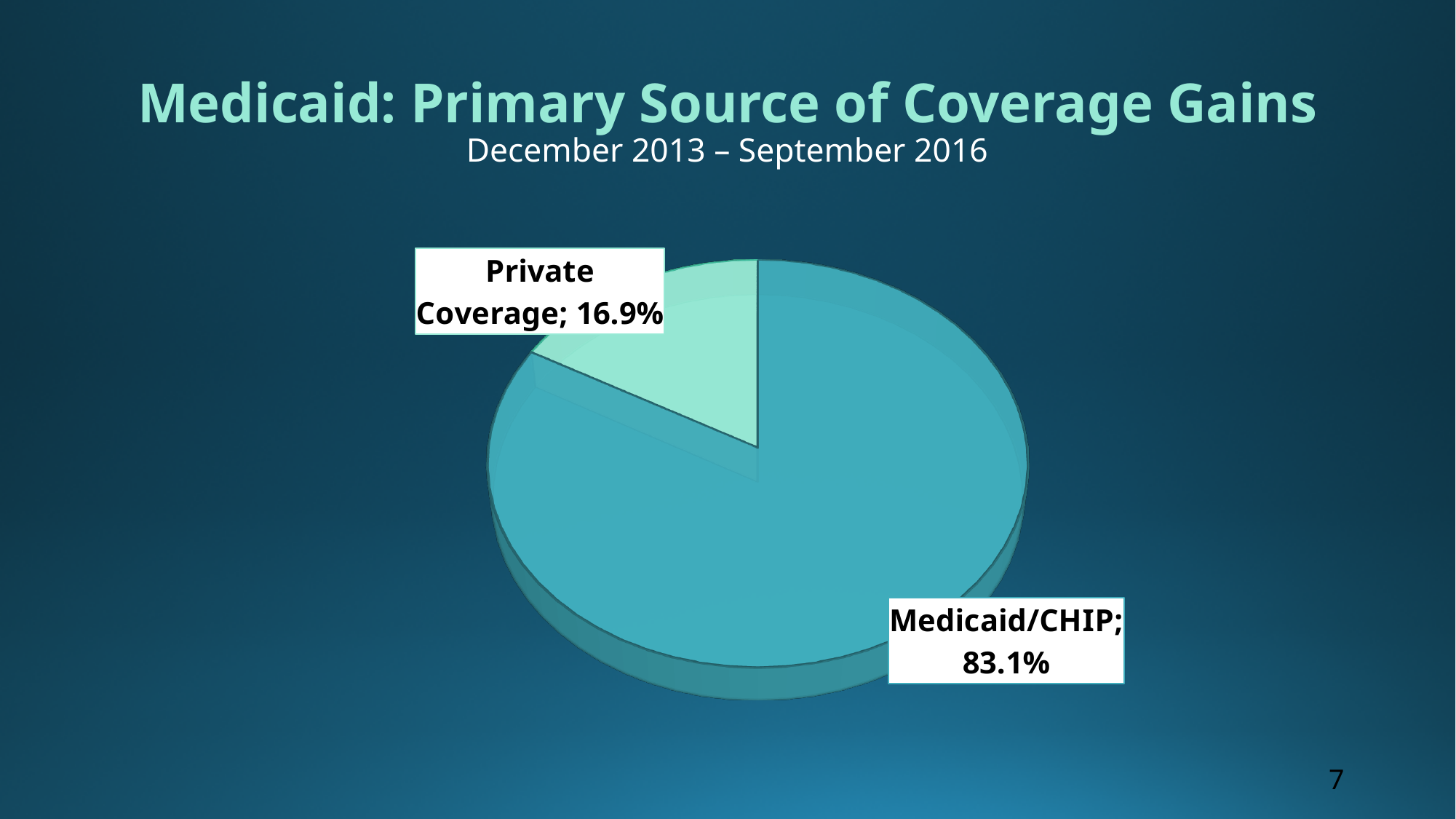
What is the difference in percentage points between the Medicaid/CHIP slice and the Private Coverage slice? 66.2 What kind of chart is shown on the slide? pie chart Which is larger, the Medicaid/CHIP slice or the Private Coverage slice? Medicaid/CHIP What share of coverage gains does Private Coverage account for? 16.9% What time period does the subtitle of the chart cover? December 2013 – September 2016 What is the combined share of the Medicaid/CHIP and Private Coverage slices? 100% What share of coverage gains does Medicaid/CHIP account for? 83.1% How many slices does the pie chart have? 2 What is the title of the slide containing the chart? Medicaid: Primary Source of Coverage Gains Which slice of the pie is the smallest? Private Coverage Which slice of the pie is the largest? Medicaid/CHIP